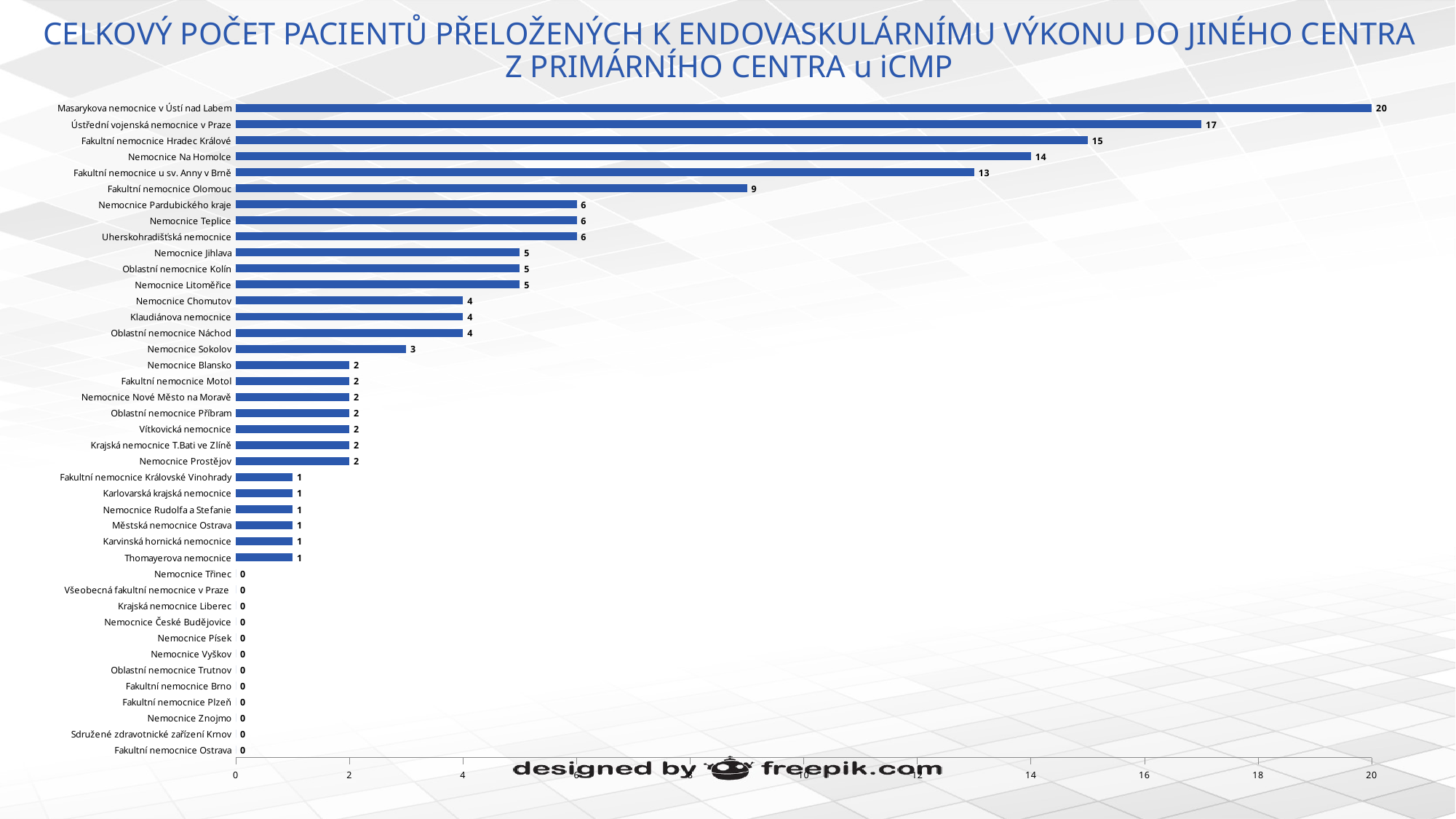
Which has a larger value, Fakultní nemocnice Hradec Králové or Fakultní nemocnice u sv. Anny v Brně? Fakultní nemocnice Hradec Králové What is the highest value shown on the horizontal axis? 20 What is the difference between the values for Ústřední vojenská nemocnice v Praze and Nemocnice Na Homolce? 3 How many hospitals are listed in the chart? 41 What is the value for Nemocnice Třinec? 0 What is the value for Fakultní nemocnice Olomouc? 9 What is the value for Masarykova nemocnice v Ústí nad Labem? 20 How many hospitals have a value of 0? 12 What is the value for Nemocnice Sokolov? 3 Which hospital has the highest value? Masarykova nemocnice v Ústí nad Labem What kind of chart is shown on the slide? Bar chart Is the value for Fakultní nemocnice u sv. Anny v Brně greater or less than 10? greater